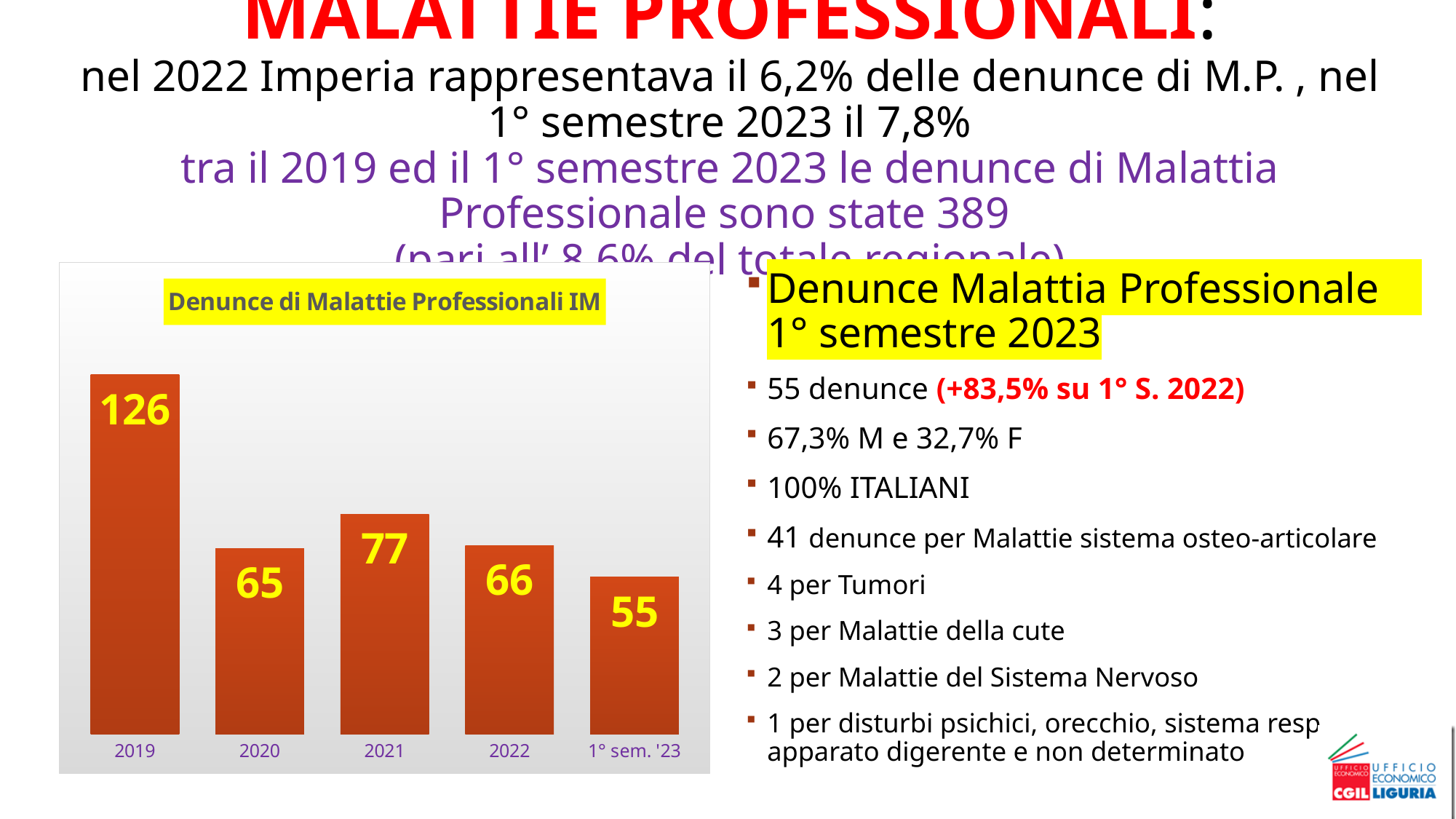
What is the difference between the values for 2019 and 2020? 61 What is the value for 2019 in the chart? 126 What colour are the bars in the chart? orange-red What is the value for 1° sem. '23 in the chart? 55 What kind of chart is shown on the slide? bar chart What is the value for 2021 in the chart? 77 What is the difference between the values for 2021 and 2022? 11 How many categories are shown on the x axis of the chart? 5 Which is larger, the value for 2021 or the value for 2020? 2021 What is the title of the chart? Denunce di Malattie Professionali IM Which category has the lowest value in the chart? 1° sem. '23 Which category has the highest value in the chart? 2019